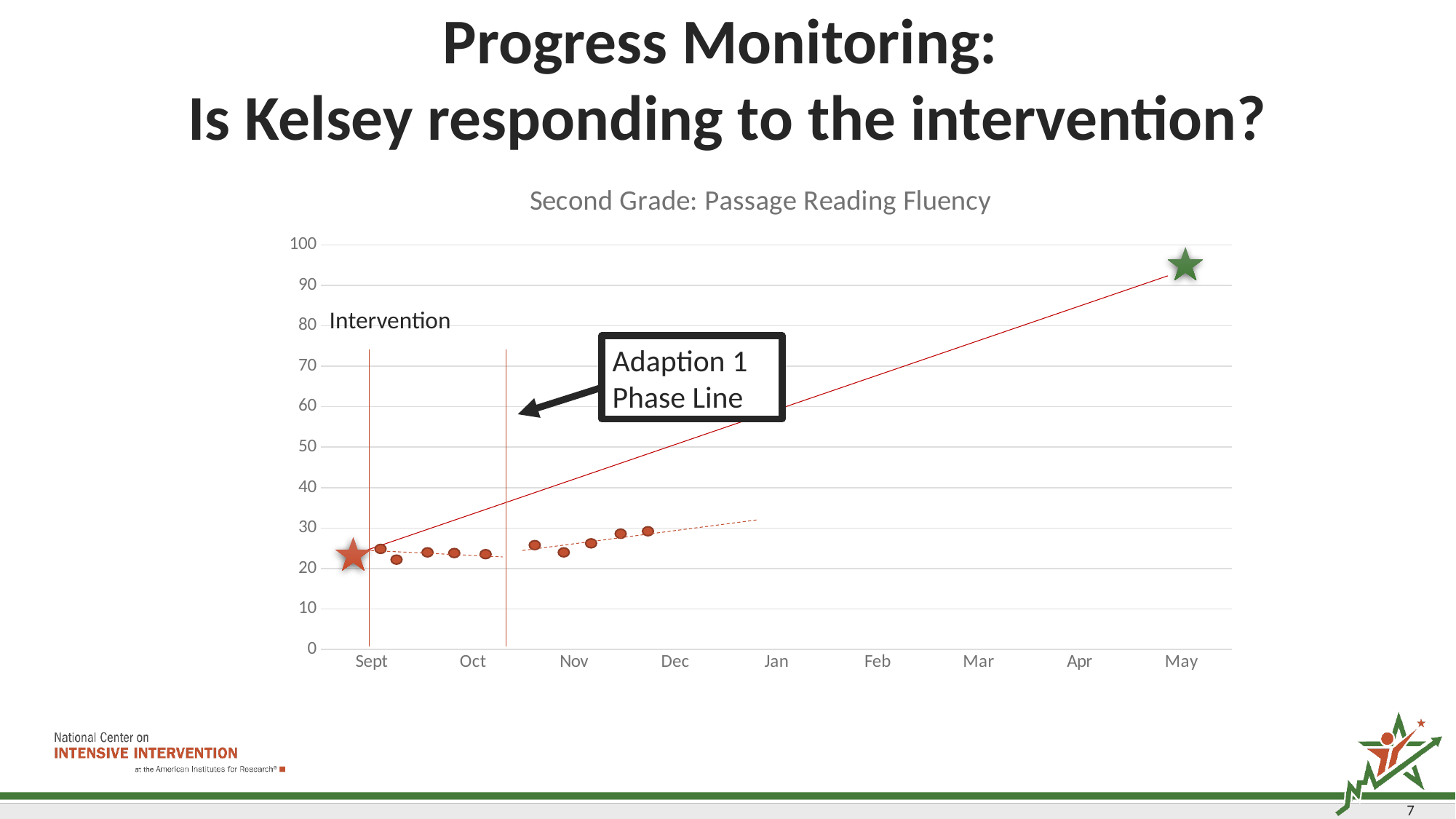
What is the highest value shown on the y axis? 100 How many months are labelled on the x axis of the chart? 9 Is the value of the last plotted data point (just before Dec) greater or less than 20? greater Are all of the plotted data points below 40? yes What is the title of the chart? Second Grade: Passage Reading Fluency What is the first month labelled on the x axis? Sept What kind of chart is shown on the slide? line chart Is the value of the green goal star in May greater or less than 90? greater Which is larger, the value of the green goal star in May or the value of the orange starting star in Sept? the green goal star in May How many plotted data points (excluding the stars) are shown on the chart? 10 Do the plotted data points after the Adaption 1 Phase Line rise or fall over time? rise